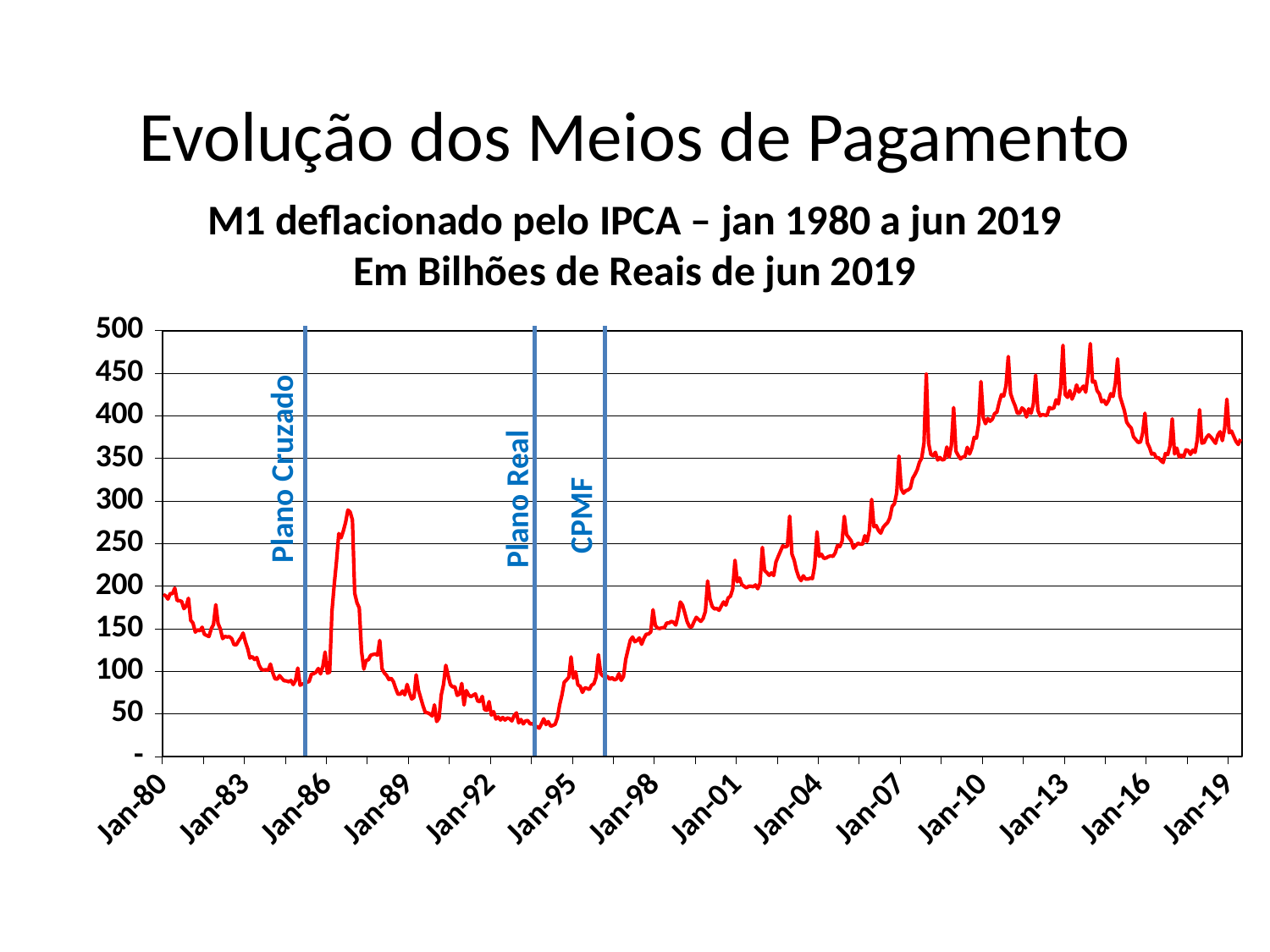
Is the highest value reached on the chart greater or less than 450? greater What period does the chart subtitle say the M1 series covers? jan 1980 a jun 2019 Which is larger, the value at Jan-13 or the value at Jan-92? Jan-13 What kind of chart is shown on the slide? line chart Between Jan-80 and Jan-86, does the line generally rise or fall? fall Which is larger, the value at Jan-80 or the value at Jan-95? Jan-80 Is the value at Jan-92 greater or less than 100? less Between Jan-98 and Jan-10, does the line generally rise or fall? rise What are the labels of the three vertical marker lines on the chart? Plano Cruzado, Plano Real, CPMF Is the value at Jan-04 greater or less than 300? less